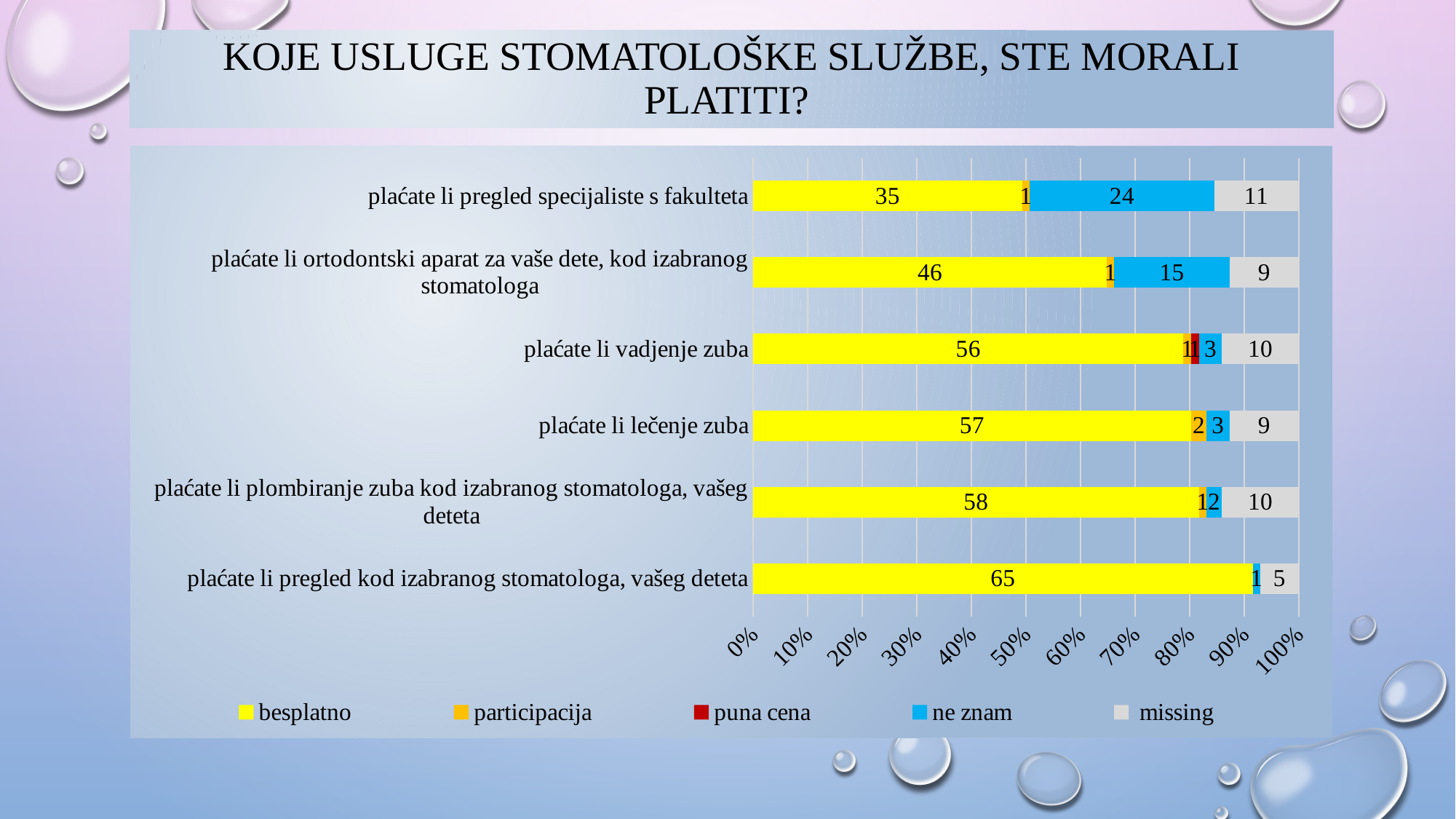
Which category has the lowest 'besplatno' value? plaćate li pregled specijaliste s fakulteta What colour represents the 'besplatno' series in the legend? yellow What is the 'besplatno' value for 'plaćate li pregled specijaliste s fakulteta'? 35 What kind of chart is shown on the slide? bar chart What is the difference between the 'besplatno' values for 'plaćate li plombiranje zuba kod izabranog stomatologa, vašeg deteta' and 'plaćate li lečenje zuba'? 1 Which has the larger 'ne znam' value: 'plaćate li pregled specijaliste s fakulteta' or 'plaćate li ortodontski aparat za vaše dete, kod izabranog stomatologa'? plaćate li pregled specijaliste s fakulteta What is the 'ne znam' value for 'plaćate li ortodontski aparat za vaše dete, kod izabranog stomatologa'? 15 What is the 'missing' value for 'plaćate li pregled kod izabranog stomatologa, vašeg deteta'? 5 How many series does the legend list? 5 How many categories (questions) are plotted on the chart? 6 What is the total of all segments in the bar for 'plaćate li vadjenje zuba'? 71 Which category has the highest 'besplatno' value? plaćate li pregled kod izabranog stomatologa, vašeg deteta